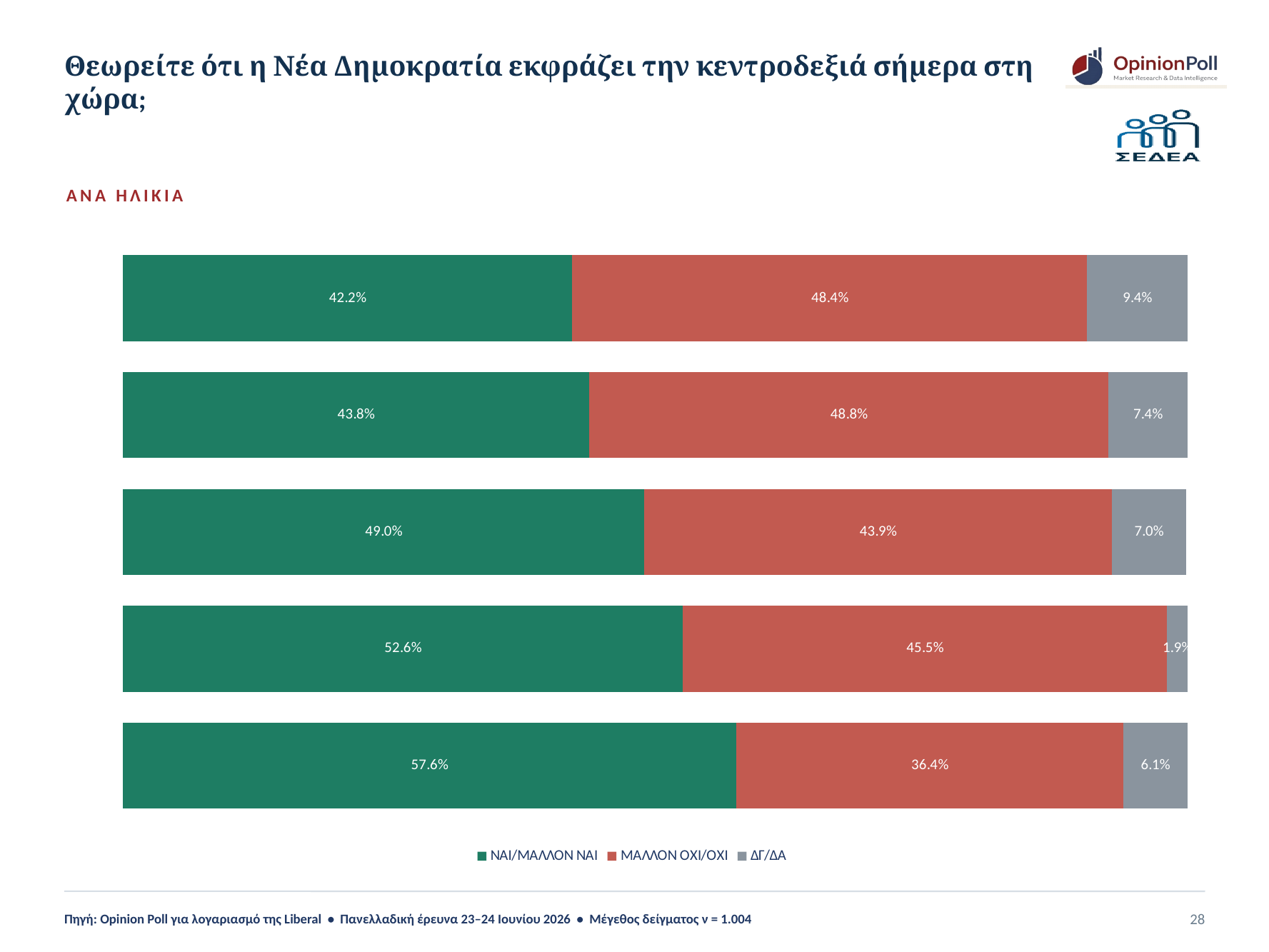
What kind of chart is shown on the slide? Stacked bar chart Which colour represents ΔΓ/ΔΑ in the chart? Grey Do the ΝΑΙ/ΜΑΛΛΟΝ ΝΑΙ values rise or fall going from the top bar to the bottom bar? Rise Which bar has the lowest ΔΓ/ΔΑ value? The fourth bar from the top (1.9%) In the third bar from the top, which is larger: ΝΑΙ/ΜΑΛΛΟΝ ΝΑΙ or ΜΑΛΛΟΝ ΟΧΙ/ΟΧΙ? ΝΑΙ/ΜΑΛΛΟΝ ΝΑΙ (49.0%) How many series does the legend list? 3 How many bars are plotted in the chart? 5 What is the difference between the ΝΑΙ/ΜΑΛΛΟΝ ΝΑΙ values of the bottom bar and the top bar? 15.4 percentage points Which bar has the highest ΝΑΙ/ΜΑΛΛΟΝ ΝΑΙ value? The bottom bar (57.6%) What is the ΔΓ/ΔΑ value for the fourth bar from the top? 1.9% What is the ΜΑΛΛΟΝ ΟΧΙ/ΟΧΙ value for the bottom bar? 36.4% What is the ΝΑΙ/ΜΑΛΛΟΝ ΝΑΙ value for the top bar? 42.2%